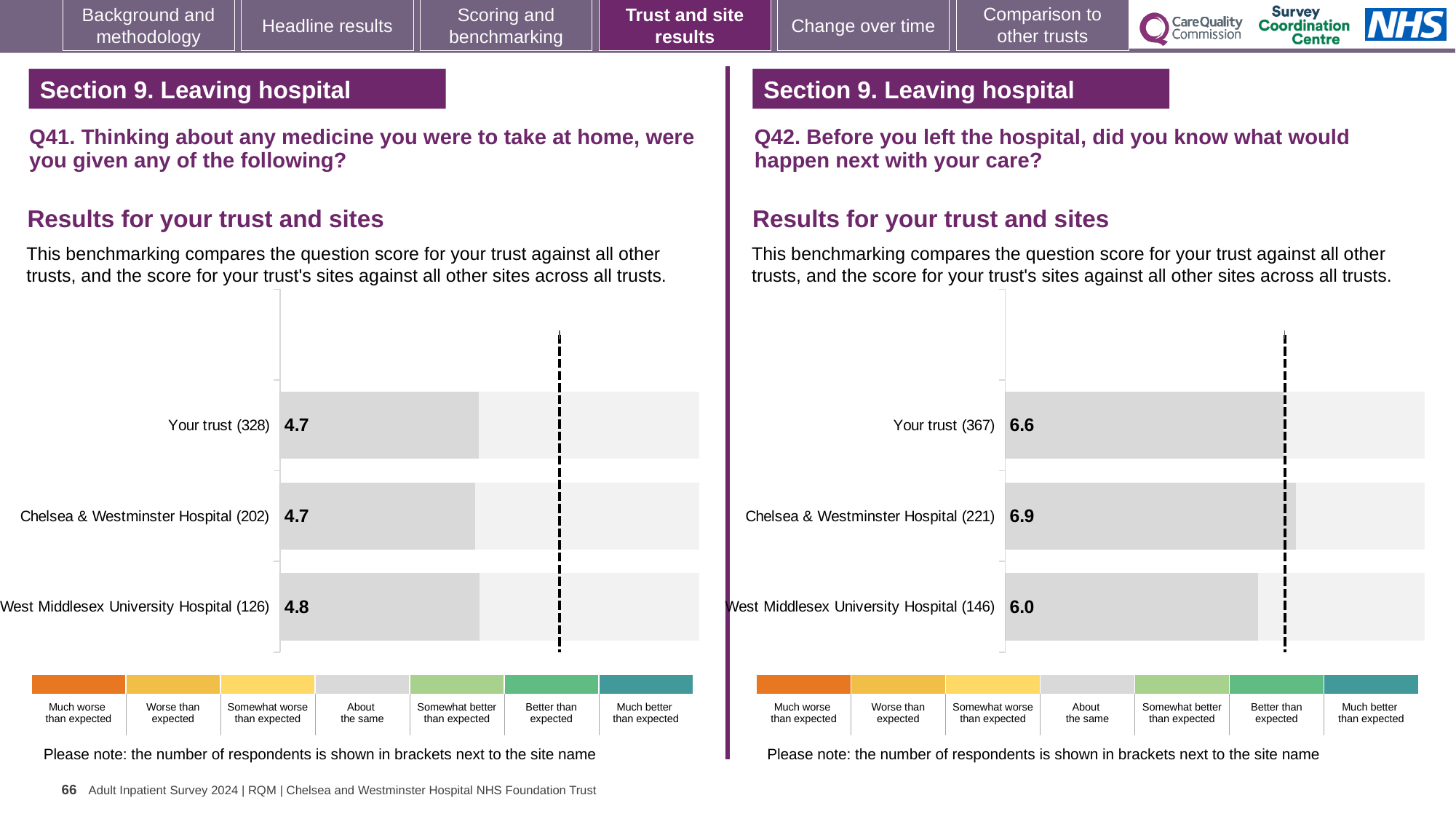
On the Q42 chart (right), how many respondents are shown in brackets for Your trust? 367 On the Q42 chart (right), which site or trust has the highest score? Chelsea & Westminster Hospital On the Q42 chart (right), what is the score for Chelsea & Westminster Hospital? 6.9 On the Q42 chart (right), which site or trust has the lowest score? West Middlesex University Hospital On the Q41 chart (left), which has the higher score: Your trust or West Middlesex University Hospital? West Middlesex University Hospital On the Q41 chart (left), how many bars are plotted? 3 On the Q41 chart (left), how many respondents are shown in brackets for Chelsea & Westminster Hospital? 202 On the Q41 chart (left), what is the score for Your trust? 4.7 On the Q42 chart (right), what is the score for West Middlesex University Hospital? 6.0 On the Q41 chart (left), what is the score for West Middlesex University Hospital? 4.8 What kind of chart is used on the Q42 chart (right)? Bar chart On the Q42 chart (right), what is the difference between the scores for Chelsea & Westminster Hospital and West Middlesex University Hospital? 0.9